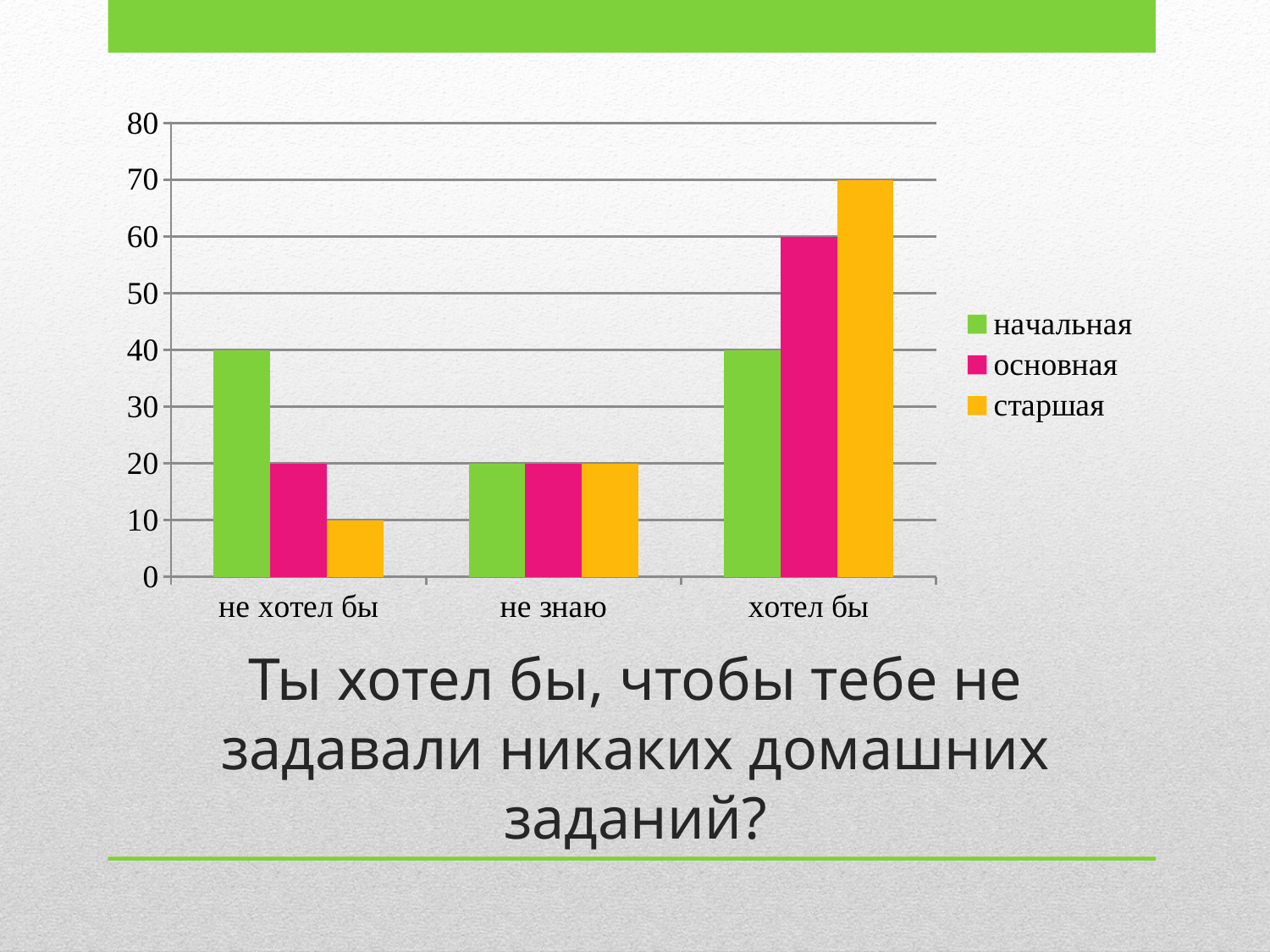
What is the difference between the старшая value for хотел бы and the старшая value for не хотел бы? 60 How many categories are shown on the x axis? 3 Which series is shown in green in the legend? начальная What is the value for начальная in the category не хотел бы? 40 What is the value for старшая in the category не хотел бы? 10 What is the value for старшая in the category хотел бы? 70 What type of chart is shown on the slide? bar chart What is the value for основная in the category хотел бы? 60 Which series has the highest value in the category хотел бы? старшая Which is larger: the начальная value for не хотел бы or the начальная value for не знаю? не хотел бы How many series does the legend list? 3 Which series has the lowest value in the category не хотел бы? старшая